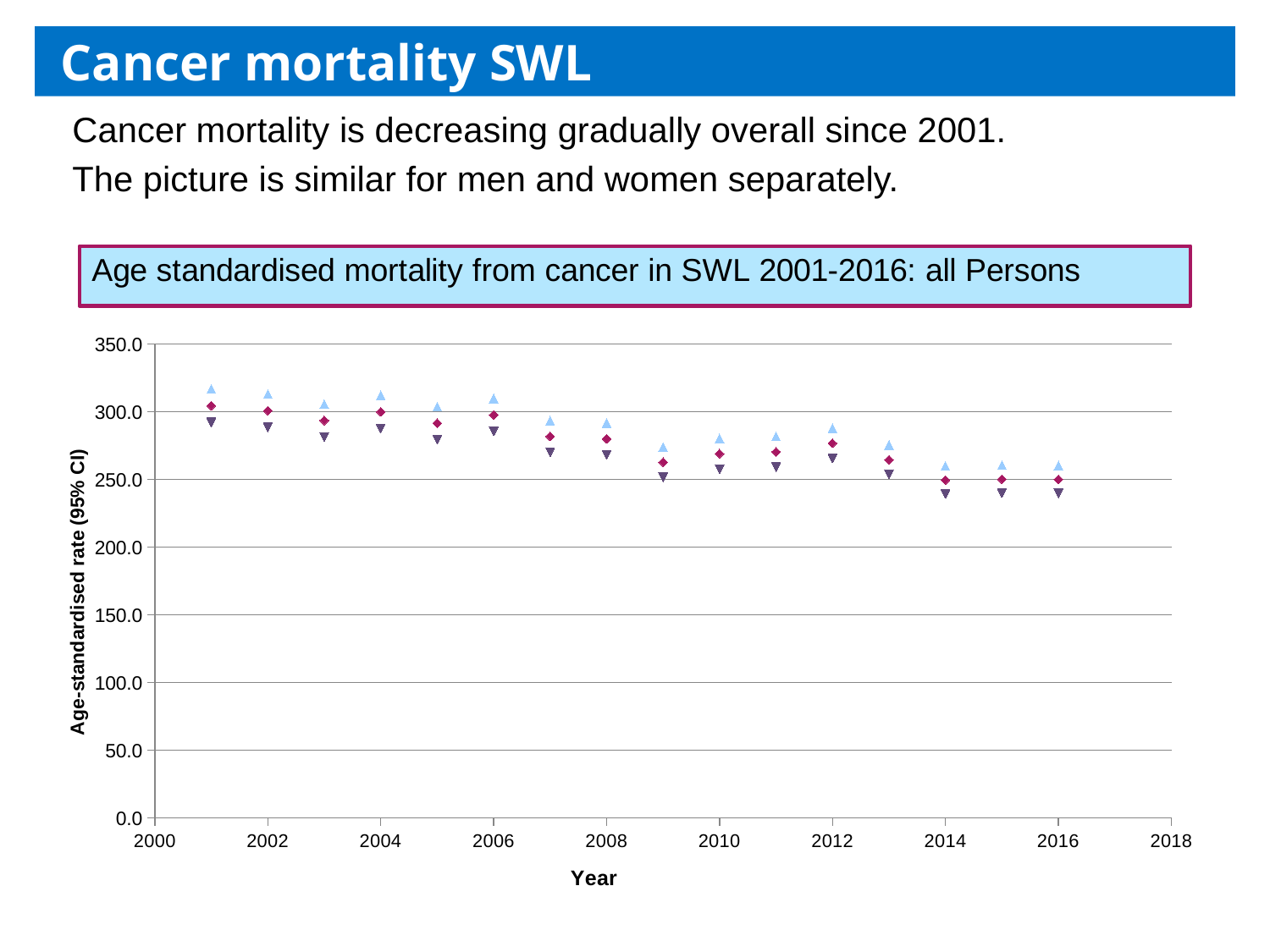
What is the label of the vertical axis? Age-standardised rate (95% CI) Is the central (point estimate) value for 2016 greater or less than 300? less Is the upper confidence limit (upward triangle) for 2001 greater or less than 300? greater Is the lower confidence limit (downward triangle) for 2016 greater or less than 250? less How many years are plotted in the chart? 16 Which year has the larger central mortality rate, 2001 or 2016? 2001 What kind of chart is shown on the slide? Scatter chart Do the age-standardised mortality rates rise or fall from 2001 to 2016? Fall Which year has the larger central mortality rate, 2006 or 2010? 2006 What is the title of the chart? Age standardised mortality from cancer in SWL 2001-2016: all Persons